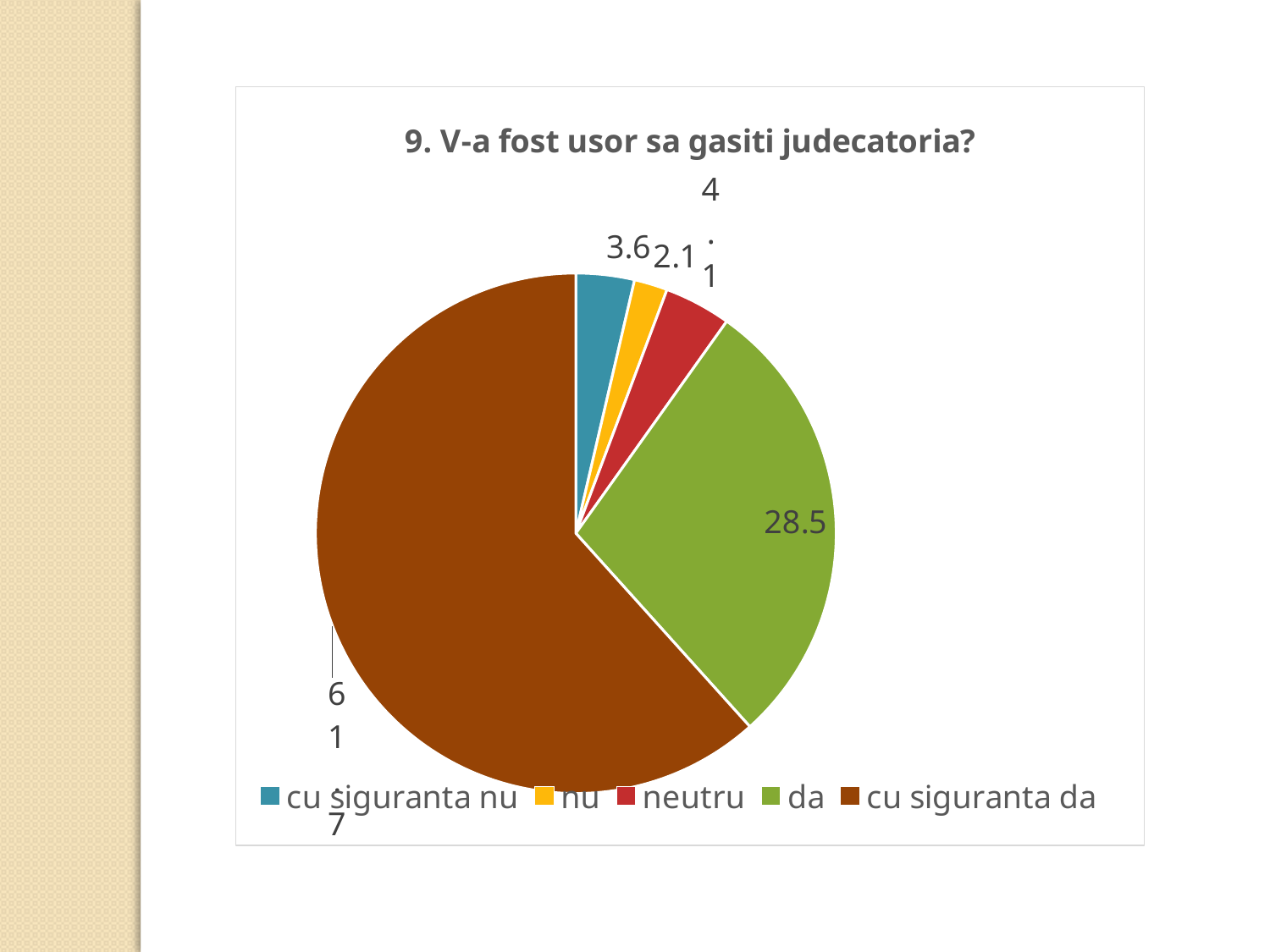
How many categories does the legend list? 5 What is the difference between the value for "cu siguranta nu" and the value for "nu"? 1.5 Which is larger, the value for "da" or the value for "cu siguranta nu"? da Which category has the smallest slice of the pie? nu What is the difference between the value for "da" and the value for "cu siguranta nu"? 24.9 What kind of chart is shown on the slide? pie chart Which category has the largest slice of the pie? cu siguranta da What is the value for "cu siguranta nu"? 3.6 What is the value for "da"? 28.5 Which colour represents "neutru" in the legend? red What is the title of the chart? 9. V-a fost usor sa gasiti judecatoria? What is the value for "nu"? 2.1